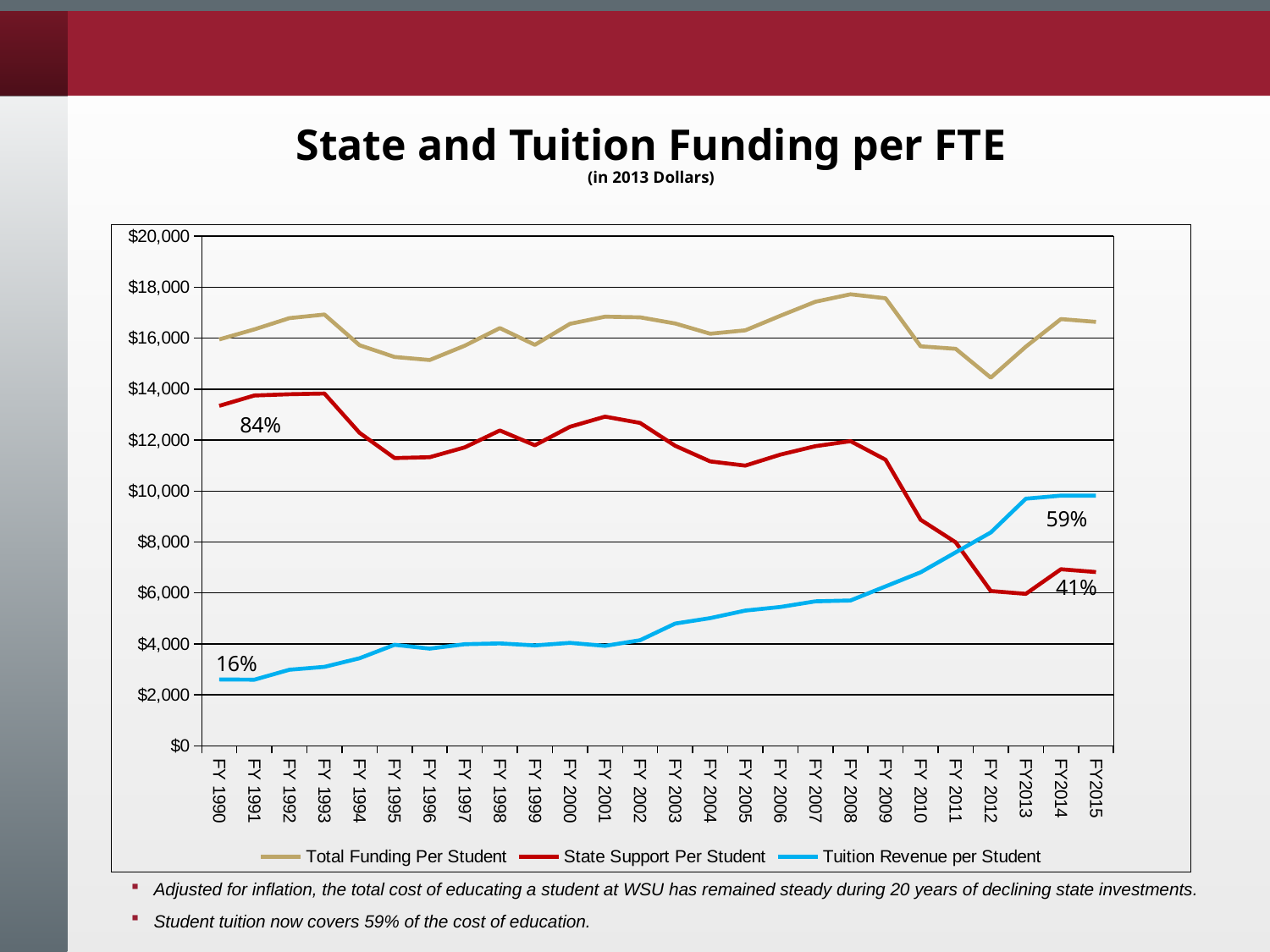
Is the value for State Support Per Student in FY 2012 greater or less than $8,000? less In FY2015, which is larger: State Support Per Student or Tuition Revenue per Student? Tuition Revenue per Student Does State Support Per Student rise or fall from FY 1990 to FY2015? fall What kind of chart is shown on the slide? line chart In FY 1990, which is larger: State Support Per Student or Tuition Revenue per Student? State Support Per Student Does Tuition Revenue per Student rise or fall from FY 1990 to FY2015? rise In which fiscal year is Total Funding Per Student at its lowest? FY 2012 How many fiscal years are plotted along the x axis? 26 Is the value for Tuition Revenue per Student in FY 1990 greater or less than $4,000? less What percentage label is shown next to the Tuition Revenue per Student line at the right end of the chart? 59% How many series does the legend list? 3 Is the value for State Support Per Student in FY 1990 greater or less than $12,000? greater